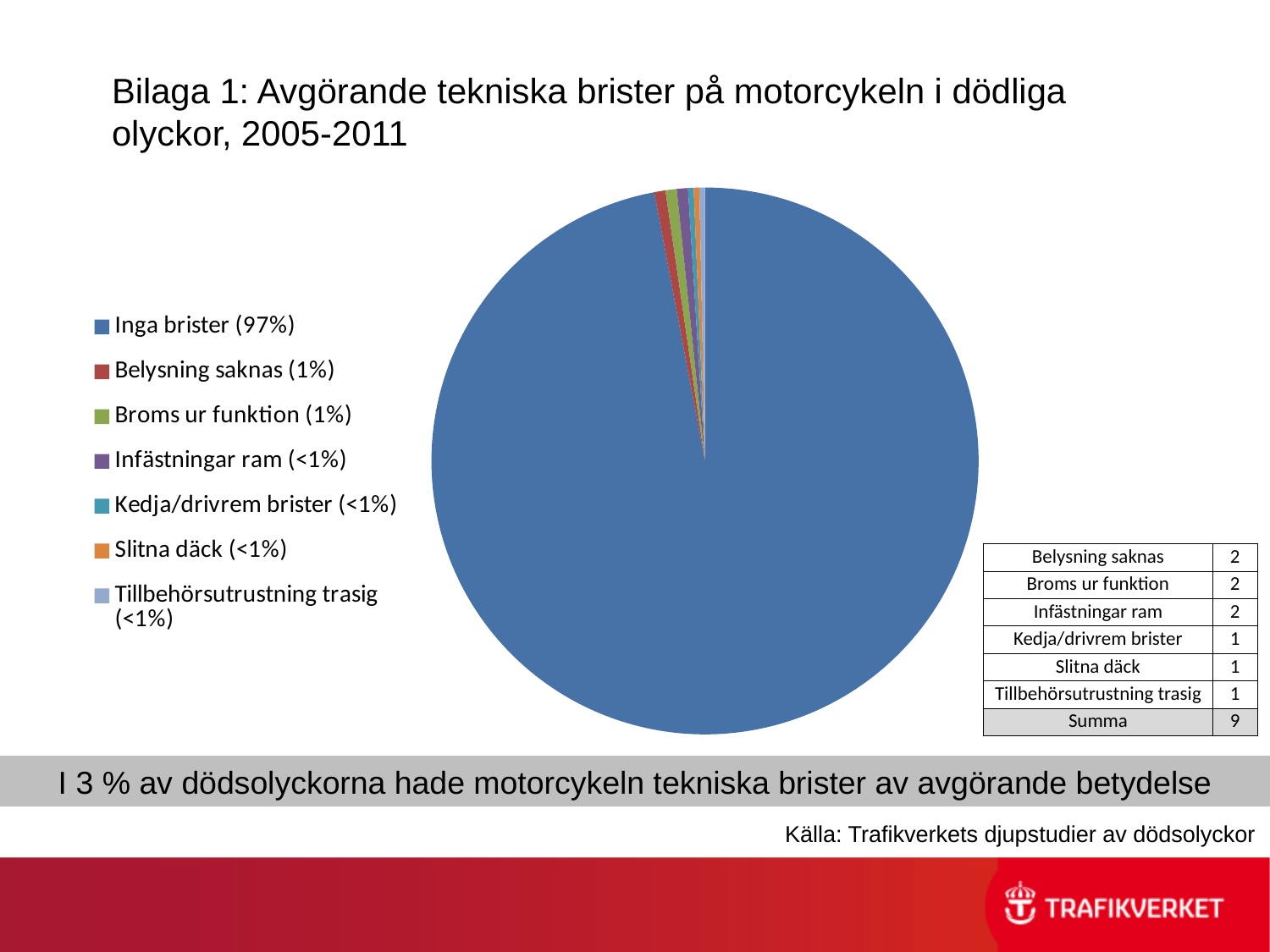
What colour is the 'Inga brister' slice in the pie chart? blue Which category has the largest slice of the pie? Inga brister What share of the pie does 'Inga brister' account for, according to the legend? 97% In the table next to the pie chart, what is the value for 'Summa'? 9 How many categories does the pie chart's legend list? 7 In the table next to the pie chart, what is the value for 'Infästningar ram'? 2 Which slice is larger: 'Inga brister' or 'Belysning saknas'? Inga brister What share of the pie does 'Broms ur funktion' account for, according to the legend? 1% What kind of chart is shown on the slide? pie chart What is the title of the slide containing the pie chart? Bilaga 1: Avgörande tekniska brister på motorcykeln i dödliga olyckor, 2005-2011 What share of the pie does 'Slitna däck' account for, according to the legend? <1%